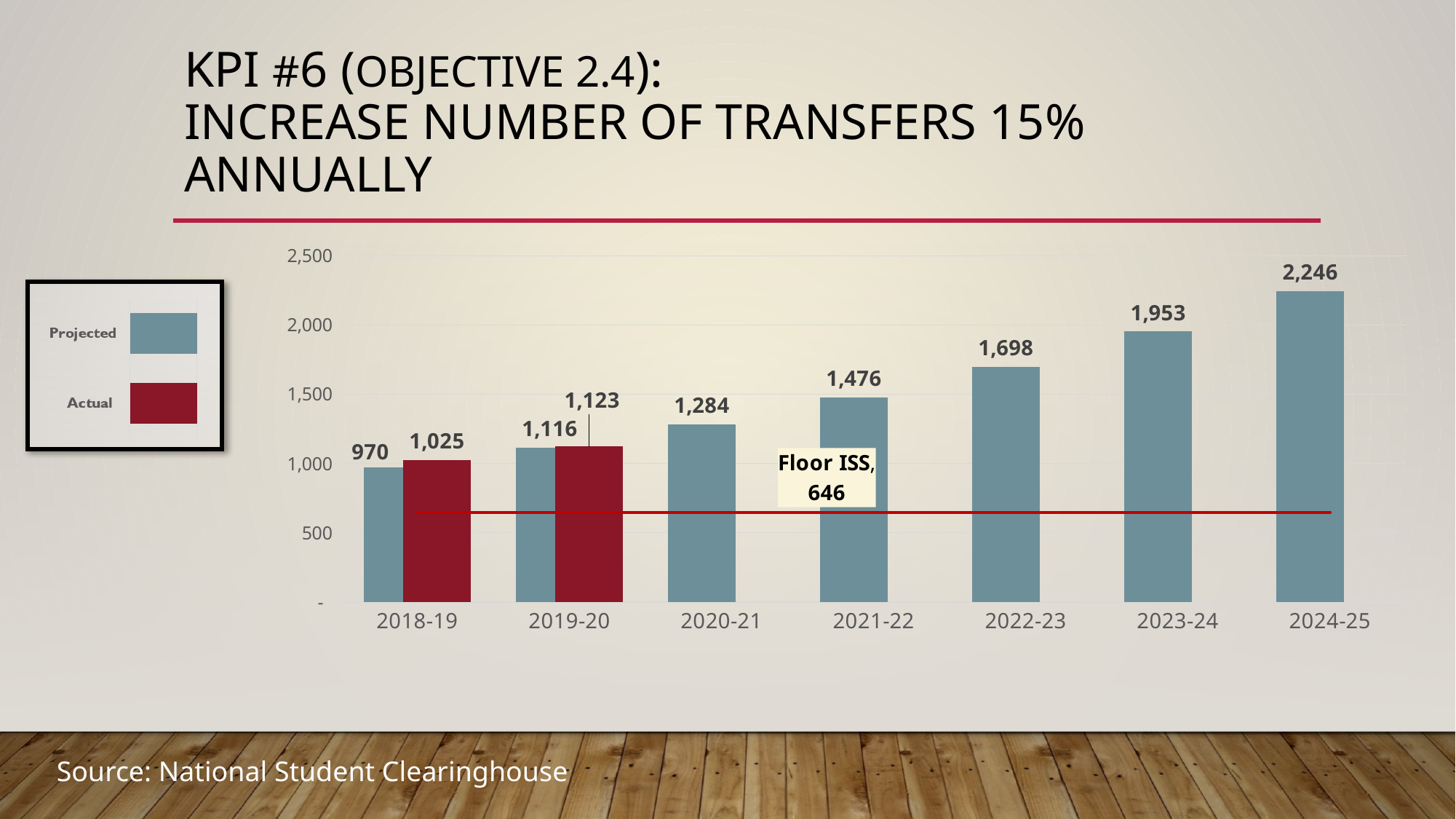
How many years are shown on the x axis? 7 How many series does the legend list? 2 Which year has the highest Projected value? 2024-25 What is the Projected value for 2021-22? 1,476 What is the difference between the Actual and Projected values for 2018-19? 55 What is the Actual value for 2018-19? 1,025 Which year has the lowest Projected value? 2018-19 What is the Actual value for 2019-20? 1,123 Which is larger for 2019-20, the Projected value or the Actual value? Actual What is the difference between the Projected values for 2024-25 and 2023-24? 293 What is the value of the Floor ISS line? 646 What is the Projected value for 2024-25? 2,246